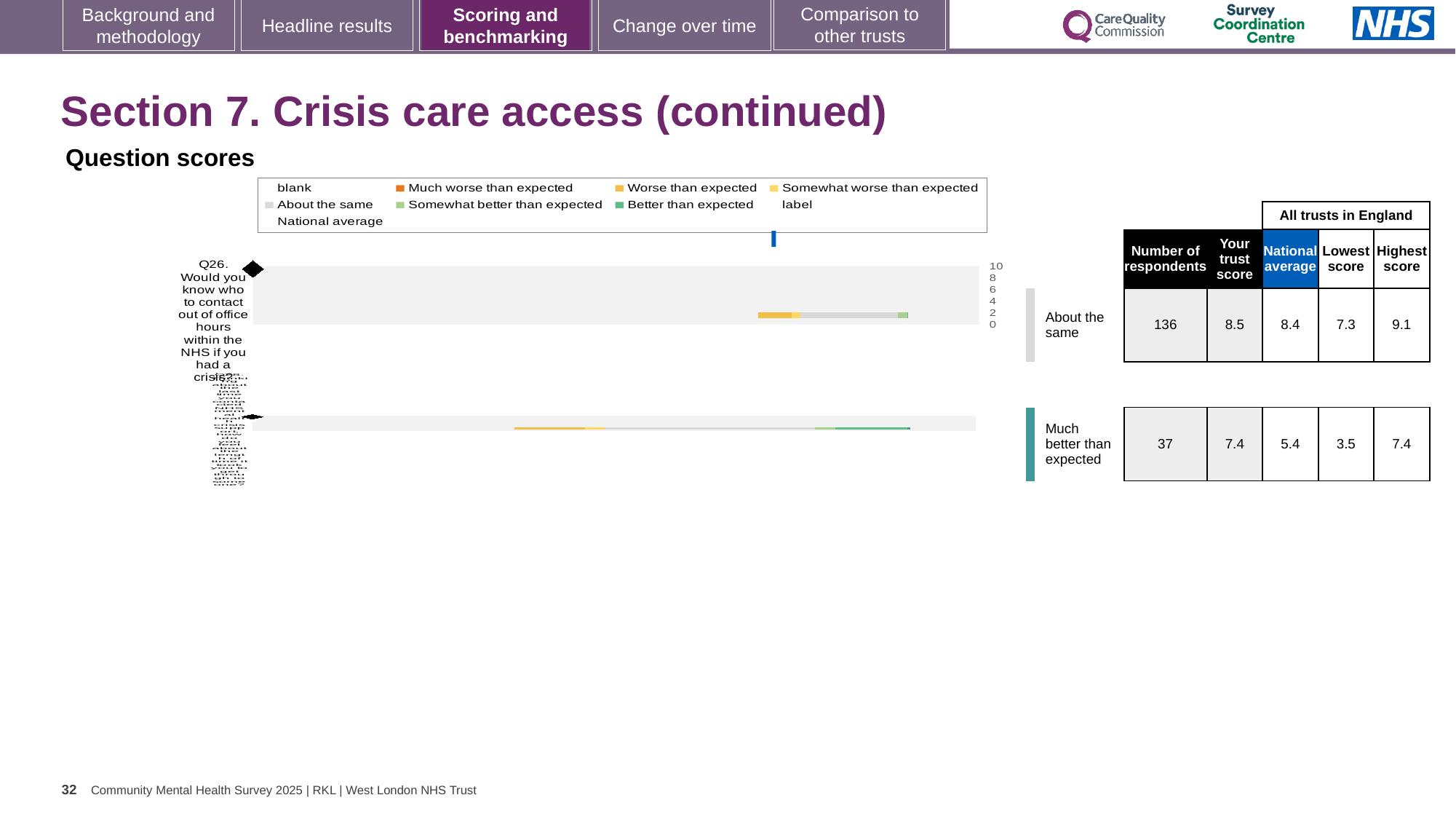
For the row labelled 'Much better than expected', what is the difference between the trust's score and the national average? 2.0 What is the benchmark category shown for Q26? About the same For the row labelled 'Much better than expected', what is the national average? 5.4 What is the lowest score among all trusts in England for Q26? 7.3 Is the trust's score for Q26 higher or lower than the national average? higher What is the national average for Q26 (Would you know who to contact out of office hours within the NHS if you had a crisis?)? 8.4 What is the number of respondents for Q26 (Would you know who to contact out of office hours within the NHS if you had a crisis?)? 136 What kind of chart is shown under 'Question scores'? bar chart What is the highest score among all trusts in England for Q26? 9.1 For the row labelled 'Much better than expected', what is the number of respondents? 37 What is the trust's score for Q26 (Would you know who to contact out of office hours within the NHS if you had a crisis?)? 8.5 For the row labelled 'Much better than expected', what is the trust's score? 7.4